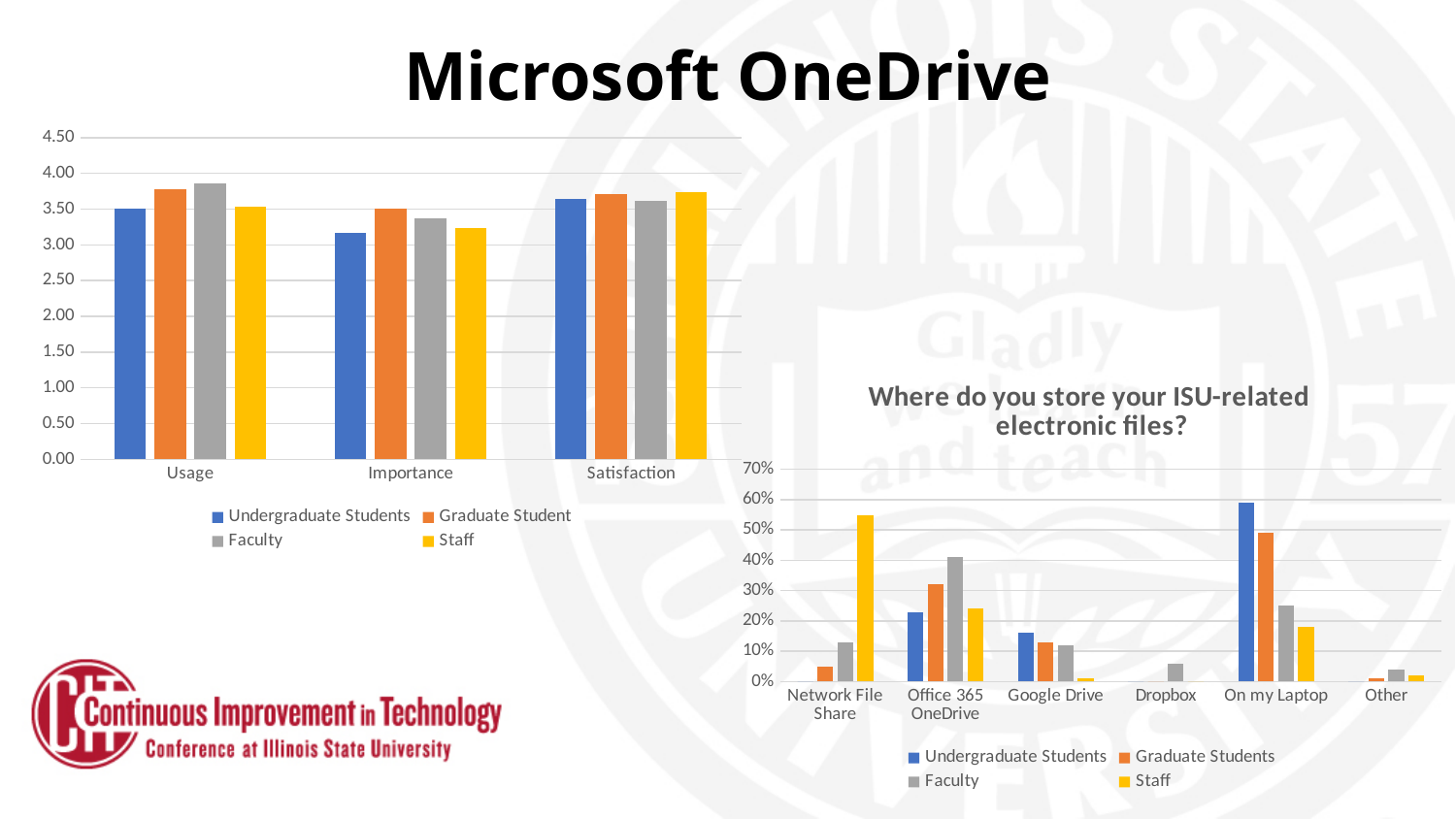
What kind of chart is the chart at the top left of the slide? bar chart On the chart at the top left of the slide, is the Undergraduate Students value for Importance greater or less than 3.50? less On the chart titled 'Where do you store your ISU-related electronic files?', is the Staff value for Network File Share greater or less than 50%? greater On the chart at the top left of the slide, how many categories are shown on the x axis? 3 On the chart titled 'Where do you store your ISU-related electronic files?', how many storage location categories are shown on the x axis? 6 On the chart titled 'Where do you store your ISU-related electronic files?', how many series does the legend list? 4 On the chart titled 'Where do you store your ISU-related electronic files?', which group has the highest value for Office 365 OneDrive? Faculty On the chart titled 'Where do you store your ISU-related electronic files?', which group has the highest value for On my Laptop? Undergraduate Students On the chart titled 'Where do you store your ISU-related electronic files?', which group has the highest value for Network File Share? Staff On the chart titled 'Where do you store your ISU-related electronic files?', is the Undergraduate Students value for On my Laptop greater or less than 50%? greater On the chart titled 'Where do you store your ISU-related electronic files?', which is larger for Google Drive: Undergraduate Students or Staff? Undergraduate Students On the chart at the top left of the slide, which group has the lowest value for Importance? Undergraduate Students